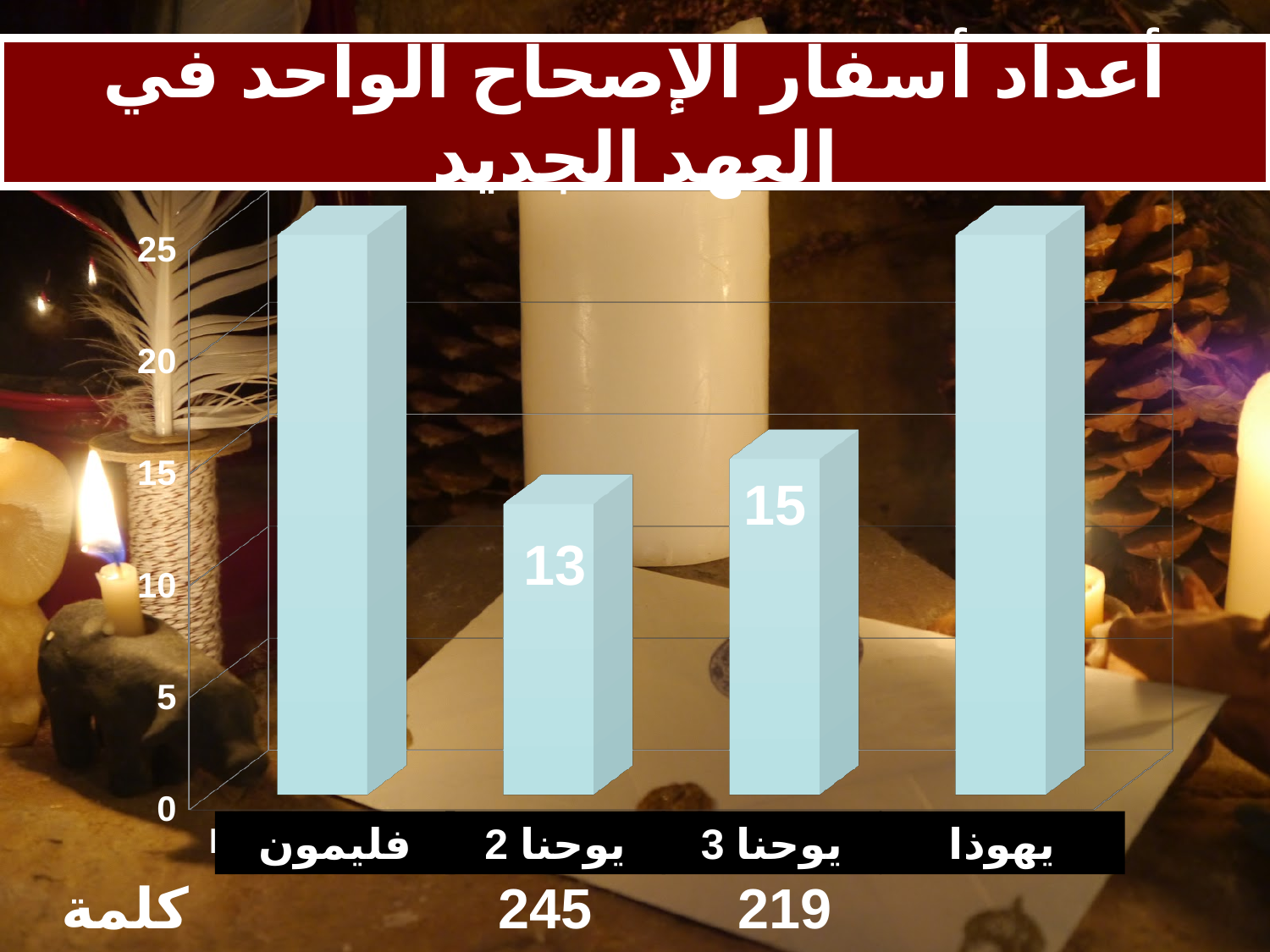
Is the value for فليمون greater or less than 20? greater Is the value for يوحنا 3 greater or less than 20? less What is the difference between the values for يوحنا 3 and يوحنا 2? 2 What is the title of the chart on the slide? أعداد أسفار الإصحاح الواحد في العهد الجديد What is the value for يوحنا 2 in the chart? 13 What kind of chart is shown on the slide? bar chart Which category has the lowest value in the chart? يوحنا 2 How many categories are shown on the x axis of the chart? 4 Is the value for يهوذا greater or less than 20? greater Which has the larger value, يوحنا 2 or يوحنا 3? يوحنا 3 What is the value for يوحنا 3 in the chart? 15 Which has the larger value, فليمون or يوحنا 2? فليمون